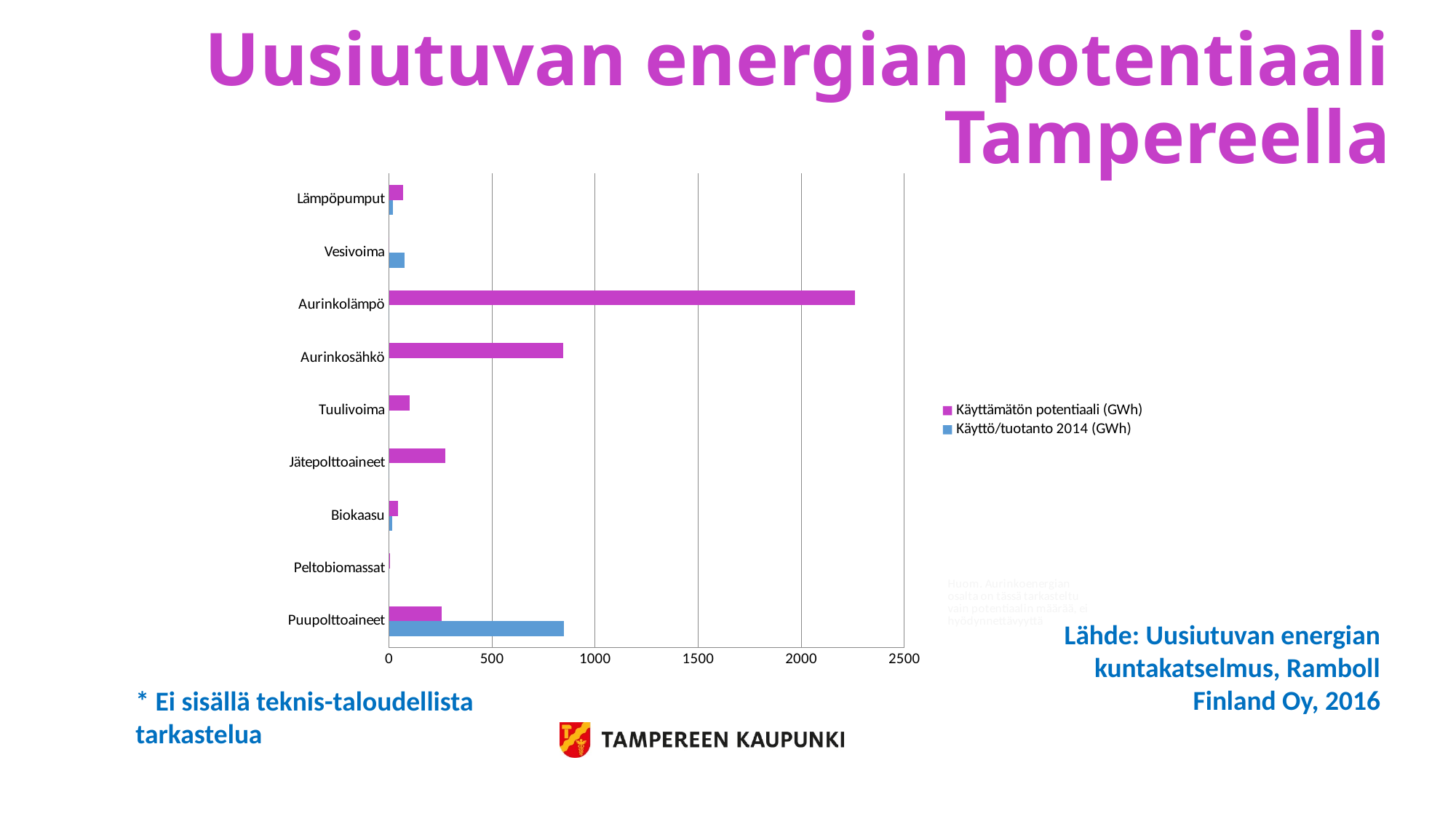
Which is larger for Puupolttoaineet: the Käyttämätön potentiaali (GWh) value or the Käyttö/tuotanto 2014 (GWh) value? Käyttö/tuotanto 2014 (GWh) Is the Käyttämätön potentiaali (GWh) value for Jätepolttoaineet greater or less than 500? less Is the Käyttämätön potentiaali (GWh) value for Aurinkolämpö greater or less than 2000? greater Which category has the highest Käyttämätön potentiaali (GWh) value? Aurinkolämpö What kind of chart is shown on the slide? bar chart Is the Käyttö/tuotanto 2014 (GWh) value for Puupolttoaineet greater or less than 500? greater How many series does the legend list? 2 Which has the larger Käyttämätön potentiaali (GWh) value: Aurinkolämpö or Aurinkosähkö? Aurinkolämpö How many categories are shown on the vertical axis of the chart? 9 Which category has the highest Käyttö/tuotanto 2014 (GWh) value? Puupolttoaineet What colour are the bars for the Käyttö/tuotanto 2014 (GWh) series? blue